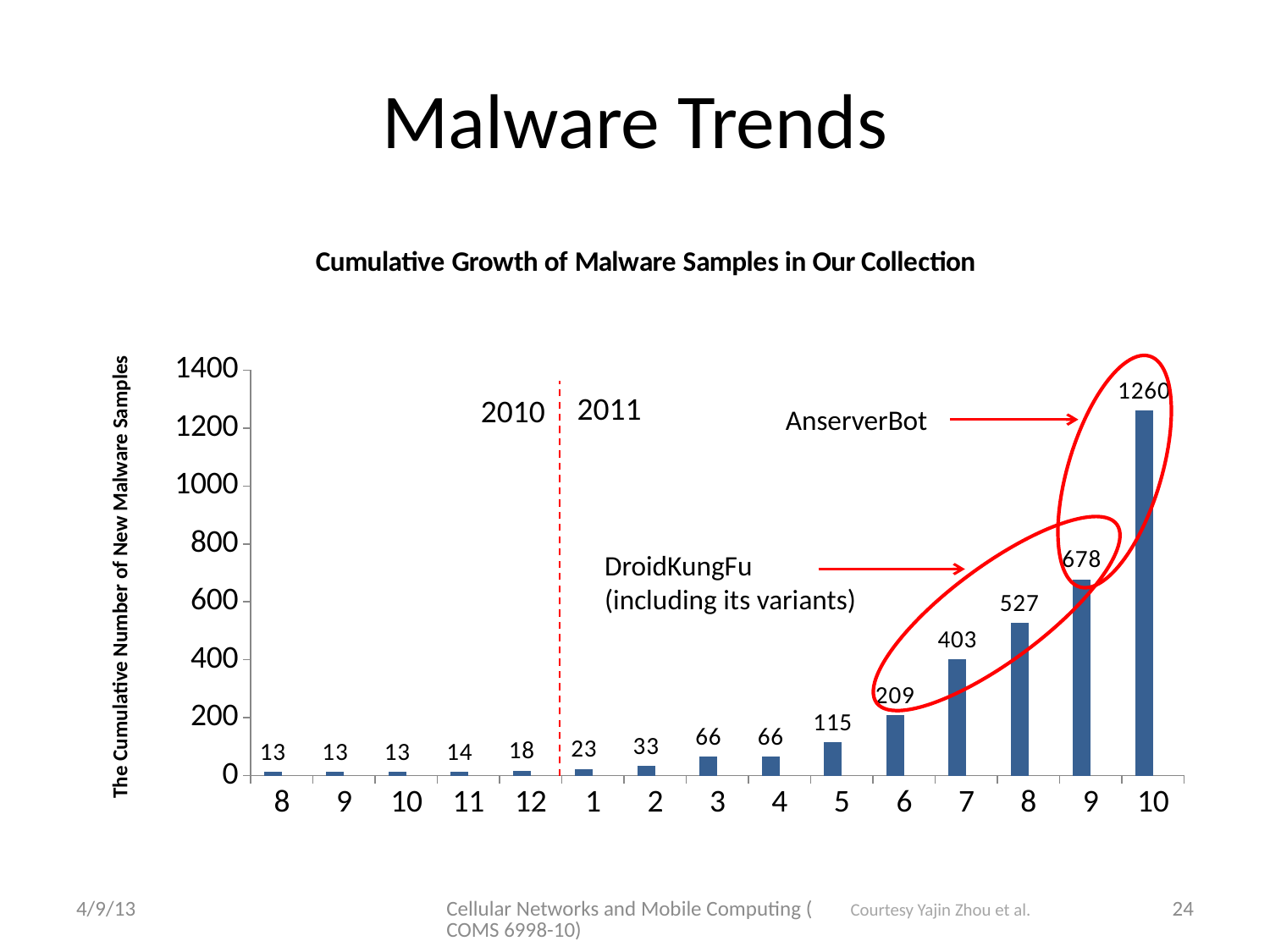
Do the values rise or fall along the x axis from left to right? Rise What is the cumulative number of new malware samples for month 6 of 2011? 209 What is the difference between the values for month 8 and month 7 of 2011? 124 What is the cumulative number of new malware samples for month 10 of 2011? 1260 What is the cumulative number of new malware samples for month 12 of 2010? 18 What kind of chart is shown on the slide? Bar chart What is the difference between the values for month 10 and month 9 of 2011? 582 What is the title of the chart? Cumulative Growth of Malware Samples in Our Collection How many bars are plotted in the chart? 15 Which month has the highest cumulative number of new malware samples? 10 (2011) Which is larger, the value for month 5 of 2011 or the value for month 4 of 2011? Month 5 of 2011 Is the value for month 9 of 2011 greater or less than 600? greater